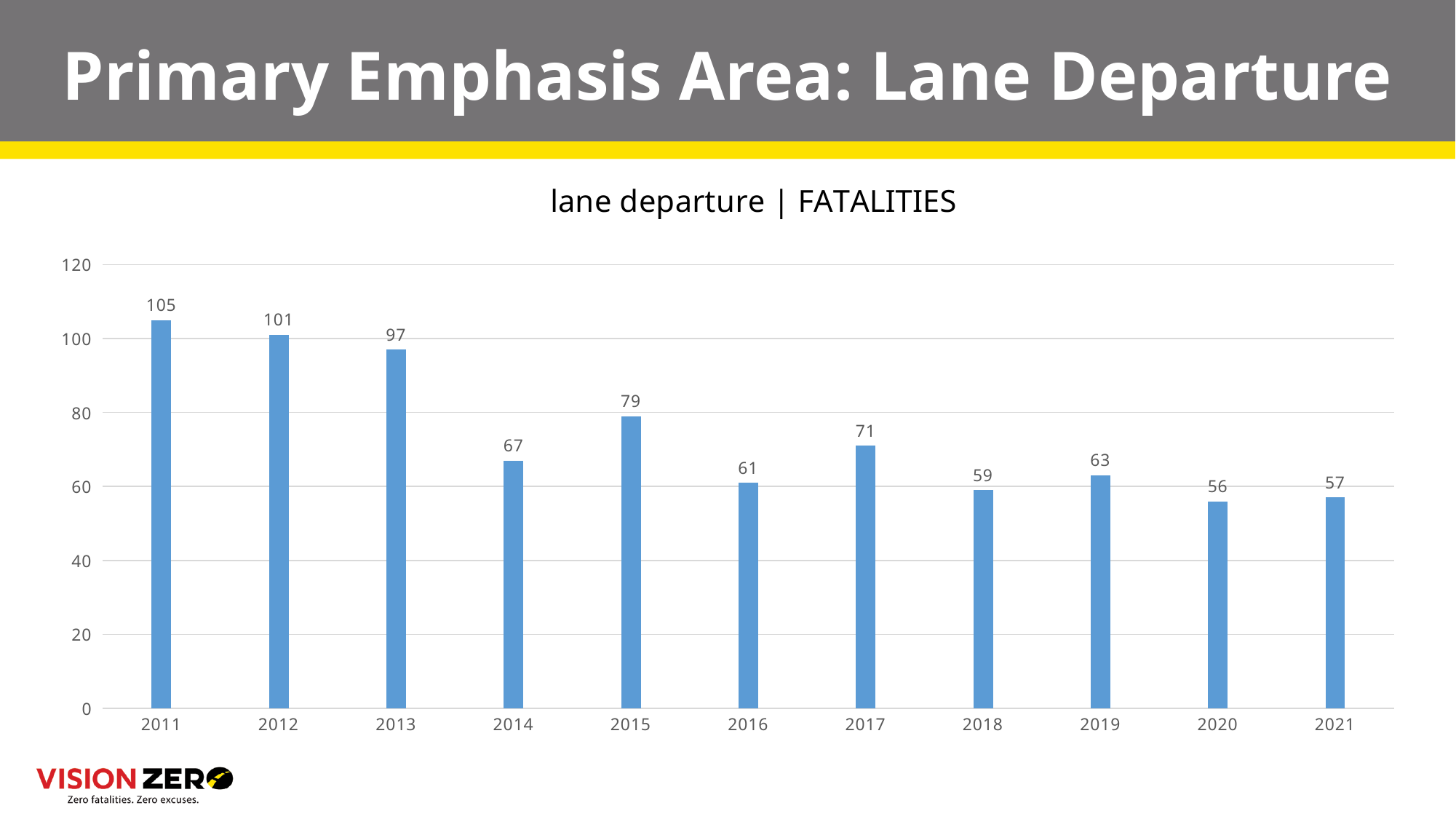
What is the number of lane departure fatalities in 2021? 57 What is the title of the chart? lane departure | FATALITIES Which year had more lane departure fatalities, 2016 or 2019? 2019 What kind of chart is shown on the slide? Bar chart What is the number of lane departure fatalities in 2011? 105 Is the value for 2013 greater or less than 100? less How many years are shown on the x axis of the chart? 11 What is the difference in lane departure fatalities between 2014 and 2015? 12 Which year has the highest number of lane departure fatalities? 2011 What is the number of lane departure fatalities in 2017? 71 What is the difference in lane departure fatalities between 2011 and 2021? 48 Which year has the lowest number of lane departure fatalities? 2020